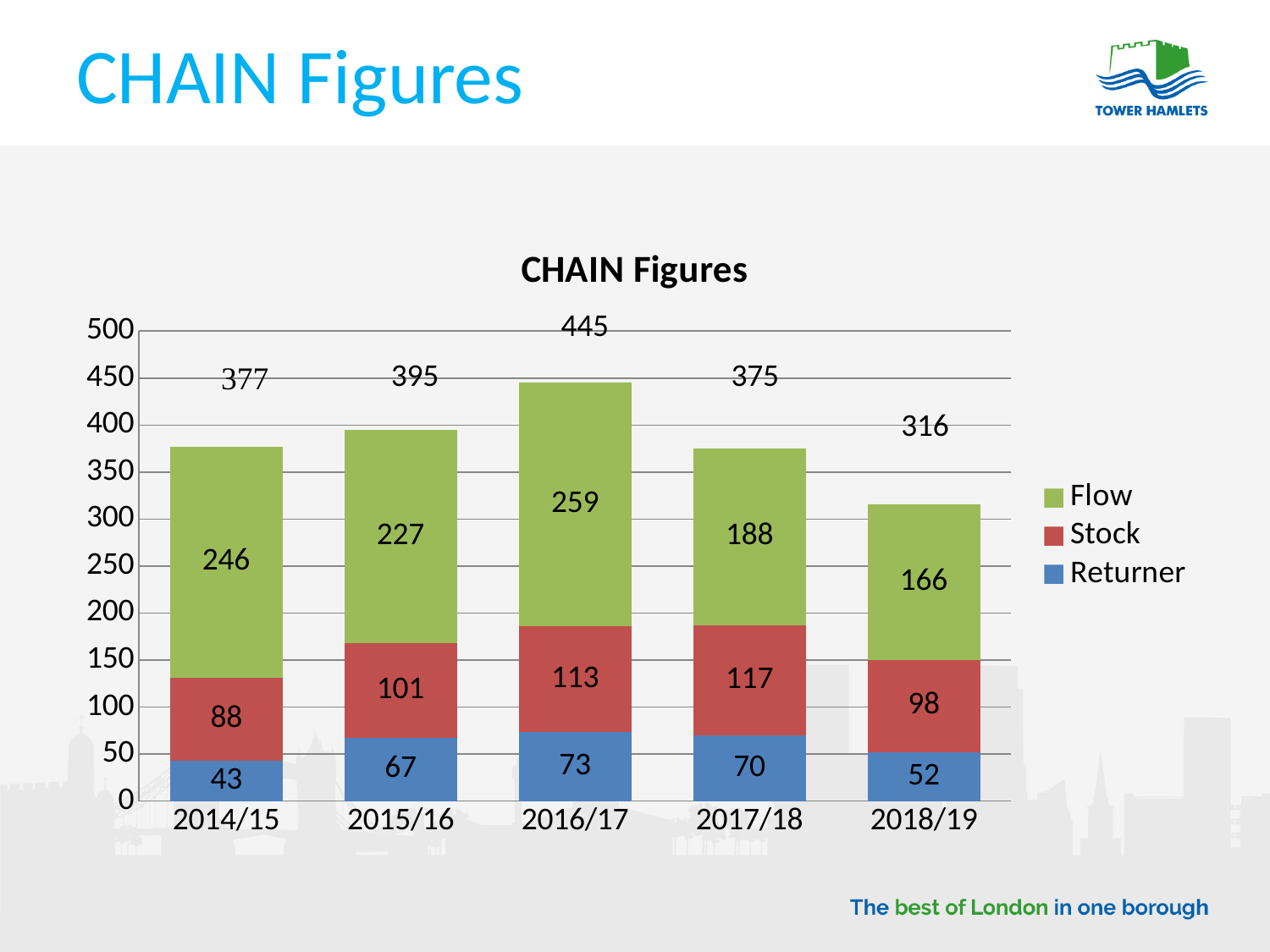
What is the Stock value for 2015/16? 101 How many series does the legend list? 3 What is the Returner value for 2018/19? 52 What is the total of the stacked bar for 2017/18? 375 Which year has the lowest Flow value? 2018/19 Which year has the highest total? 2016/17 What is the difference between the Flow values for 2014/15 and 2018/19? 80 Which is larger, the Stock value for 2017/18 or the Stock value for 2014/15? 2017/18 How many years are shown on the x axis? 5 What kind of chart is this? Stacked bar chart Which series is shown in green? Flow What is the Flow value for 2016/17? 259